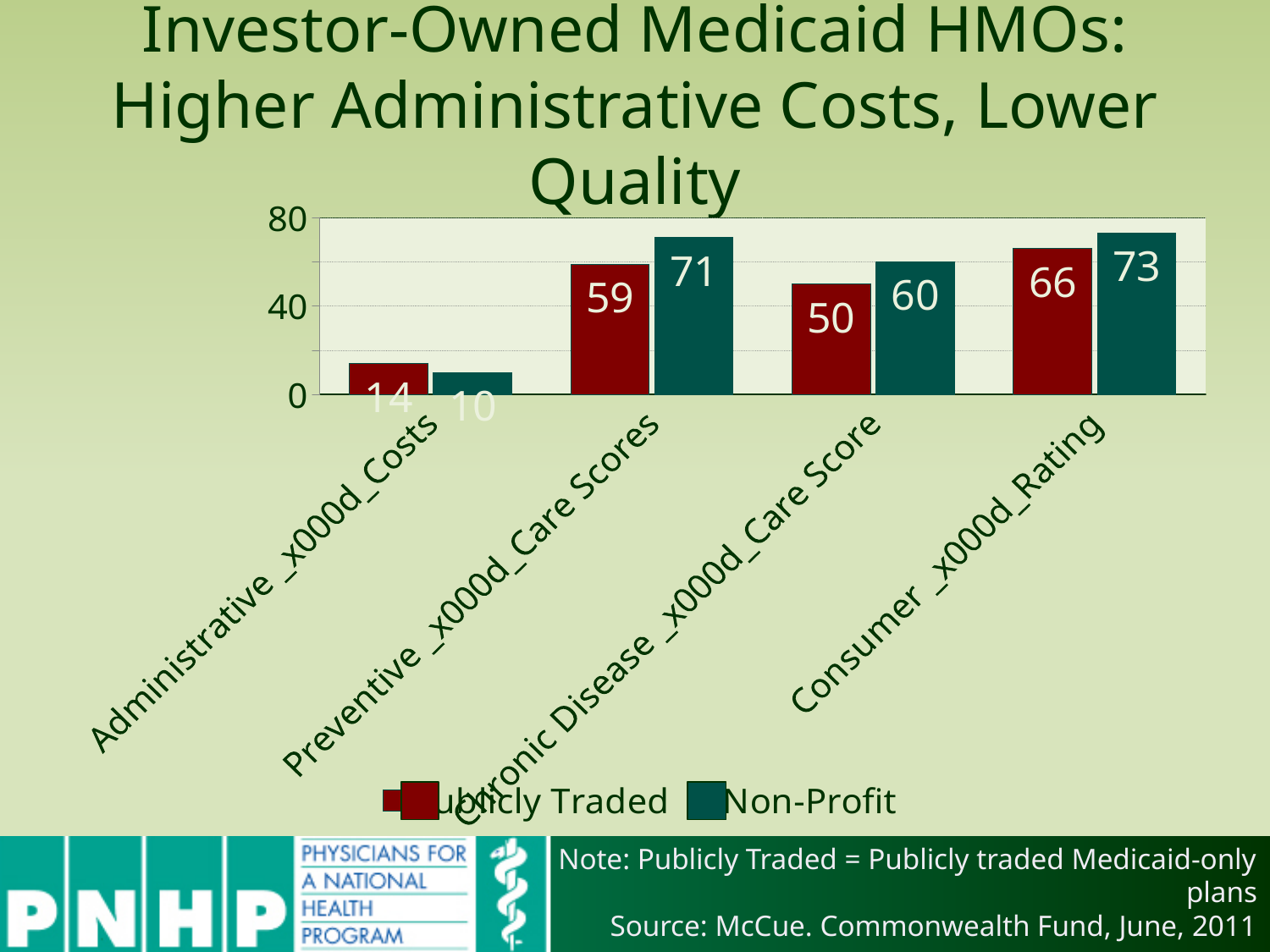
How many categories are shown on the x axis? 4 How many series does the legend list? 2 What is the Non-Profit value for Preventive Care Scores? 71 What is the Non-Profit value for Consumer Rating? 73 What is the difference between the Non-Profit and Publicly Traded values for Preventive Care Scores? 12 Which category has the highest Non-Profit value? Consumer Rating What is the Publicly Traded value for Chronic Disease Care Score? 50 What is the Publicly Traded value for Administrative Costs? 14 Which category has the lowest Publicly Traded value? Administrative Costs For Administrative Costs, which is larger: the Publicly Traded value or the Non-Profit value? Publicly Traded What kind of chart is shown on the slide? Bar chart Which series is shown in dark red? Publicly Traded